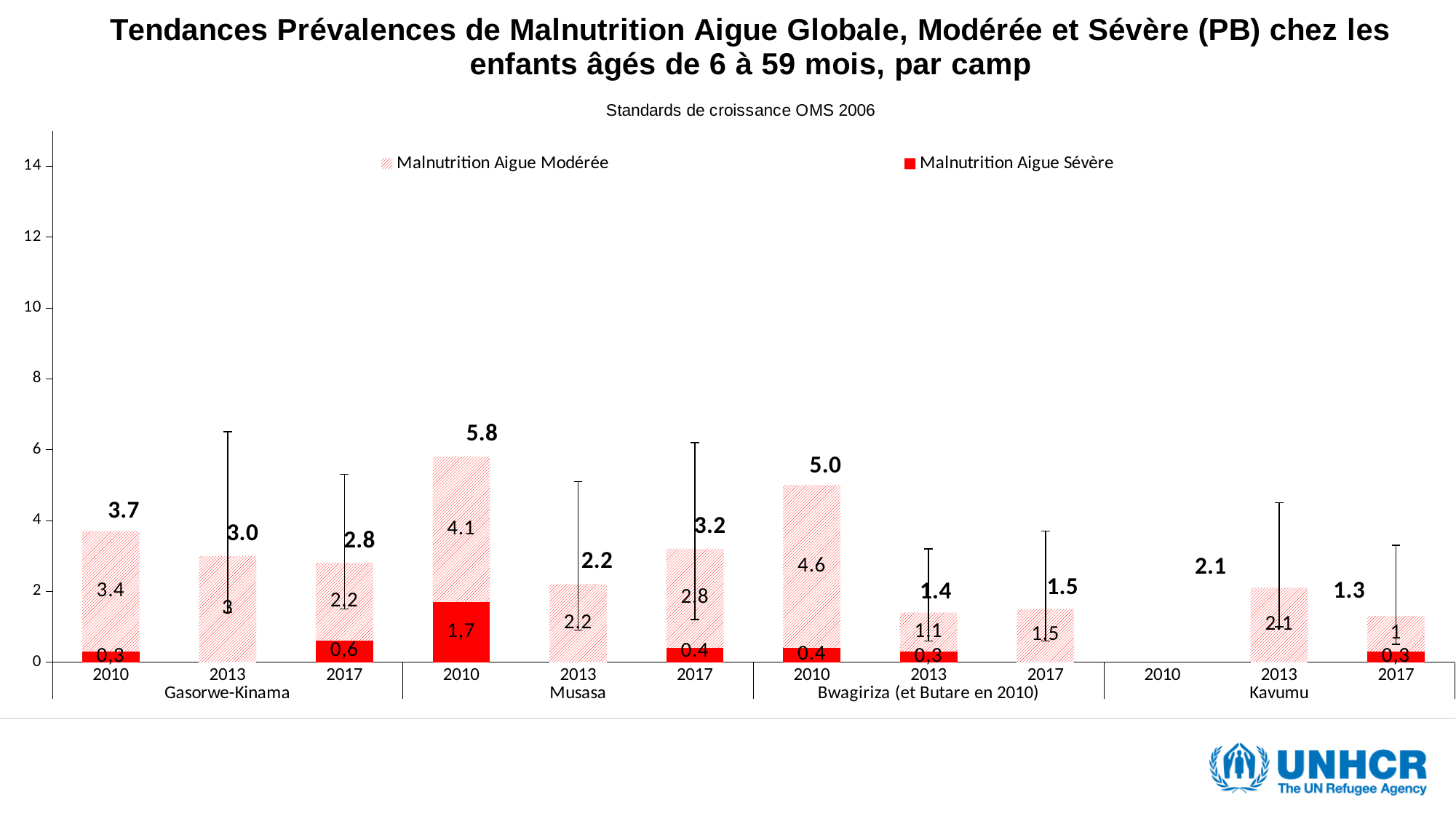
What is the difference between the 2010 total for Musasa and the 2010 total for Bwagiriza (et Butare en 2010)? 0.8 How many series does the legend list? 2 What is the Malnutrition Aigue Modérée value for Bwagiriza (et Butare en 2010) in 2010? 4.6 For Gasorwe-Kinama, which year has the larger total, 2010 or 2013? 2010 What is the total value printed above the 2010 bar for Musasa? 5.8 Which camp and year has the highest total bar? Musasa 2010 How many camps are shown along the x axis? 4 Do the total values for Gasorwe-Kinama rise or fall from 2010 to 2017? fall What kind of chart is shown on the slide? bar chart What is the Malnutrition Aigue Sévère value for Musasa in 2010? 1,7 What is the total value printed above the 2017 bar for Kavumu? 1.3 Is the 2010 total for Musasa greater or less than 4? greater